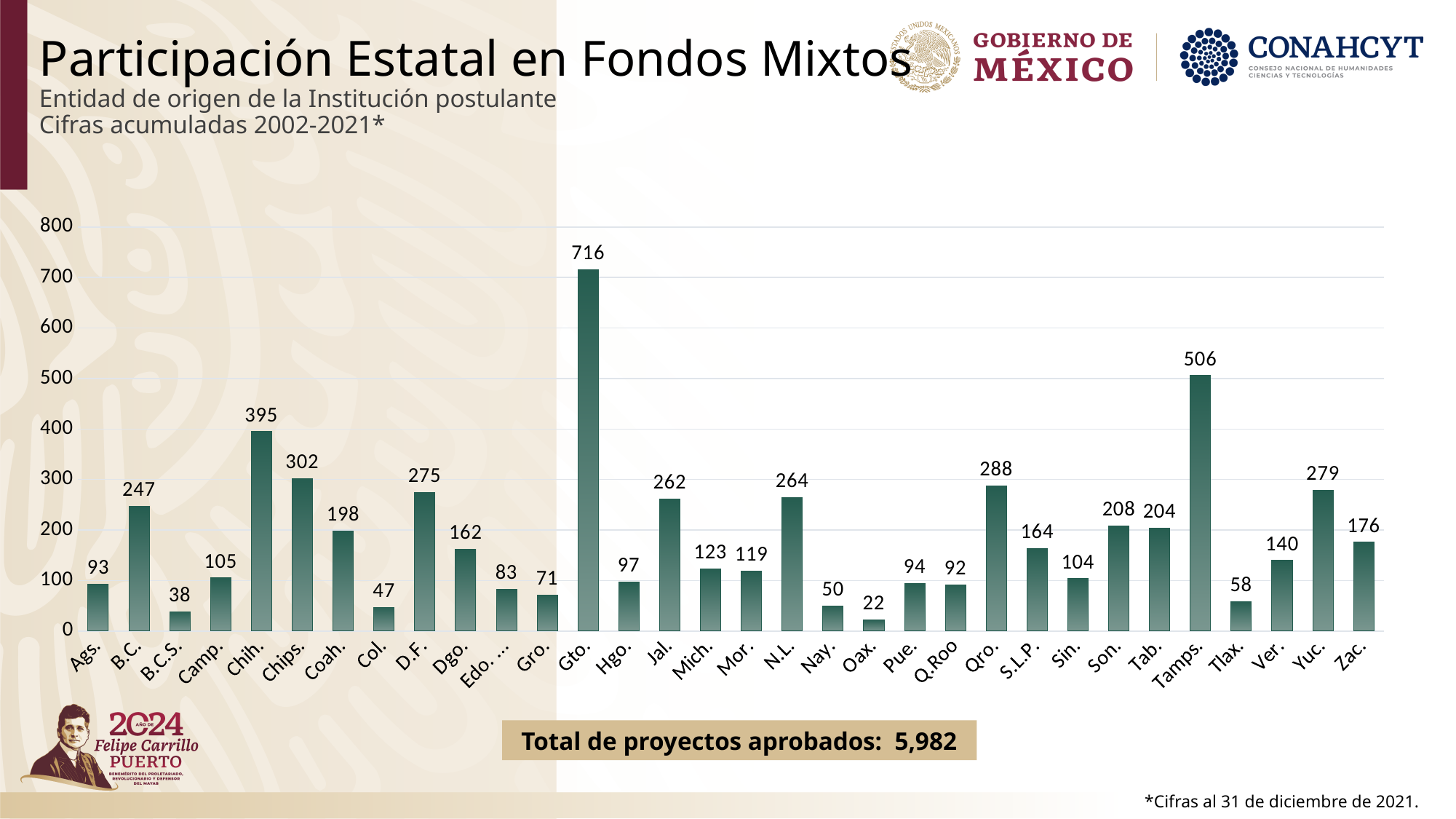
What is the value for Oax.? 22 What is the value for Gto.? 716 What kind of chart is shown on the slide? Bar chart What is the difference between the values for Chih. and Chips.? 93 What is the title of the slide's chart? Participación Estatal en Fondos Mixtos What is the value for Yuc.? 279 How many states (categories) are shown on the x axis? 32 What is the value for Tamps.? 506 What is the difference between the values for Gto. and Tamps.? 210 Which state has the lowest value? Oax. Which is larger, the value for N.L. or the value for Jal.? N.L. Which state has the highest value? Gto.